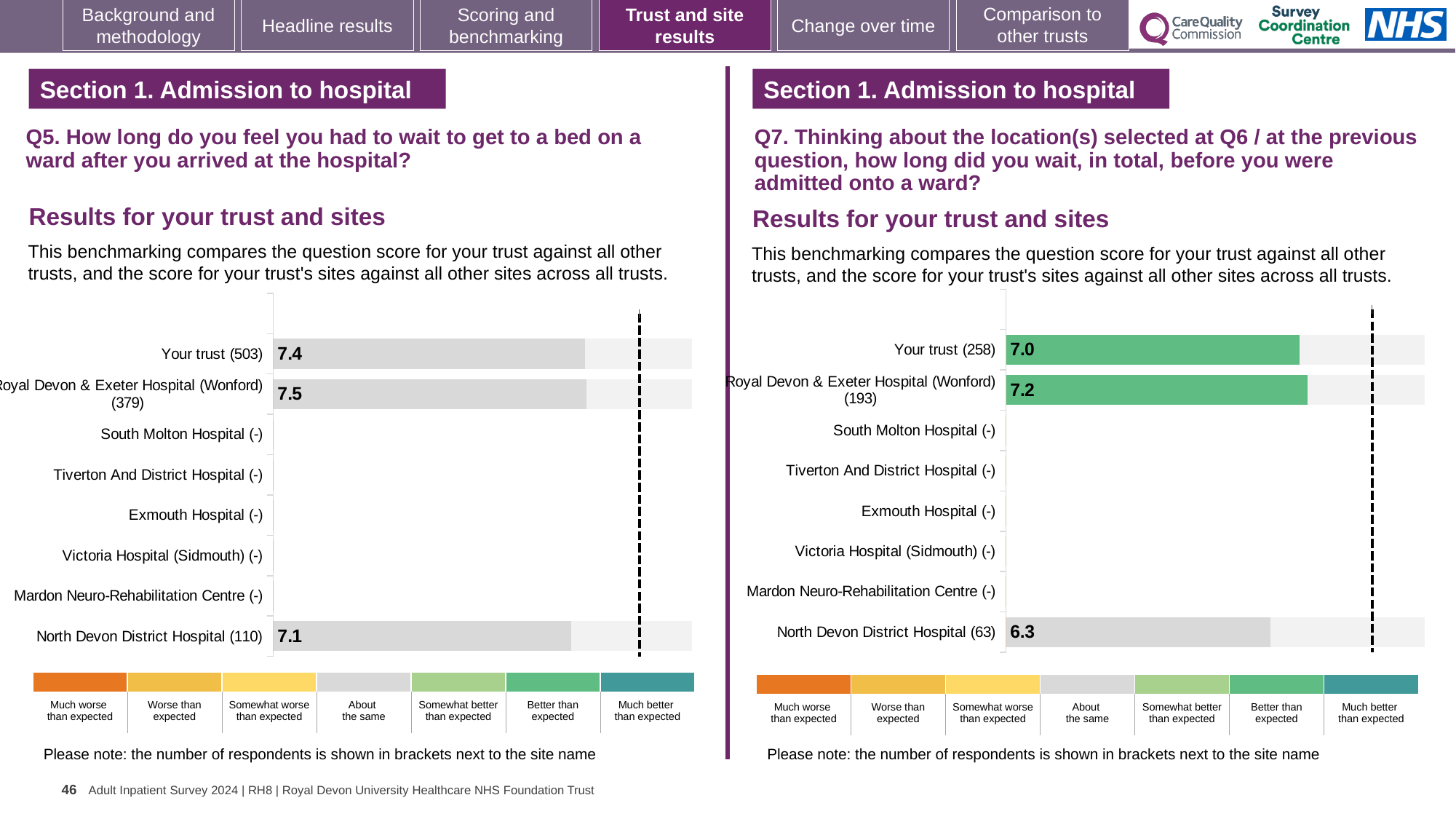
In the Q5 chart on the left, what is the score for Your trust (503)? 7.4 In the Q7 chart on the right, what is the difference between the score for Royal Devon & Exeter Hospital (Wonford) and the score for North Devon District Hospital? 0.9 In the Q5 chart on the left, which row with a plotted score has the lowest score? North Devon District Hospital (110) In the Q5 chart on the left, which is larger: the score for Your trust or the score for North Devon District Hospital? Your trust In the Q7 chart on the right, what is the score for North Devon District Hospital (63)? 6.3 What kind of chart is used for the Q7 results on the right? Bar chart In the Q5 chart on the left, what is the score for Royal Devon & Exeter Hospital (Wonford) (379)? 7.5 In the Q5 chart on the left, what is the score for North Devon District Hospital (110)? 7.1 How many site or trust rows are listed on the vertical axis of the Q5 chart on the left? 8 In the Q7 chart on the right, which site or trust row has the highest score? Royal Devon & Exeter Hospital (Wonford) (193) In the Q7 chart on the right, what is the score for Your trust (258)? 7.0 In the Q7 chart on the right, what colour is the bar for Your trust (258)? Green